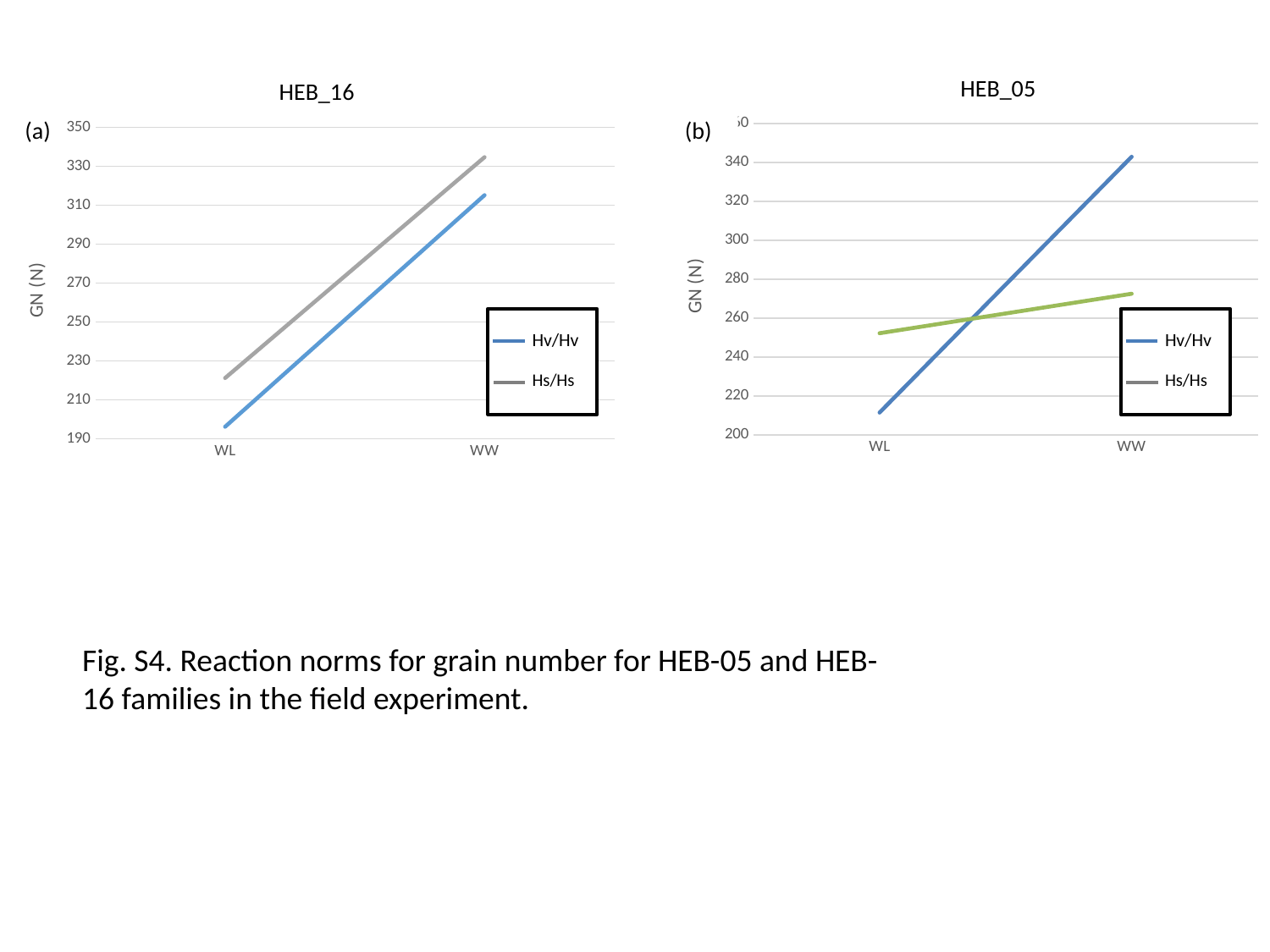
What is the y-axis label of the HEB_05 chart (b)? GN (N) What kind of chart is the HEB_16 chart (a)? line chart In the HEB_16 chart (a), is the value for Hs/Hs at WW greater or less than 330? greater In the HEB_16 chart (a), which series has the higher value at WL, Hv/Hv or Hs/Hs? Hs/Hs In the HEB_05 chart (b), which series has the higher value at WW, Hv/Hv or Hs/Hs? Hv/Hv How many series does the legend of the HEB_05 chart (b) list? 2 In the HEB_05 chart (b), which series has the higher value at WL, Hv/Hv or Hs/Hs? Hs/Hs In the HEB_05 chart (b), is the value for Hv/Hv at WL greater or less than 220? less In the HEB_16 chart (a), is the value for Hv/Hv at WL greater or less than 210? less How many categories are shown on the x axis of the HEB_16 chart (a)? 2 In the HEB_05 chart (b), does the Hs/Hs line rise or fall from WL to WW? rise In the HEB_16 chart (a), does the Hv/Hv line rise or fall from WL to WW? rise